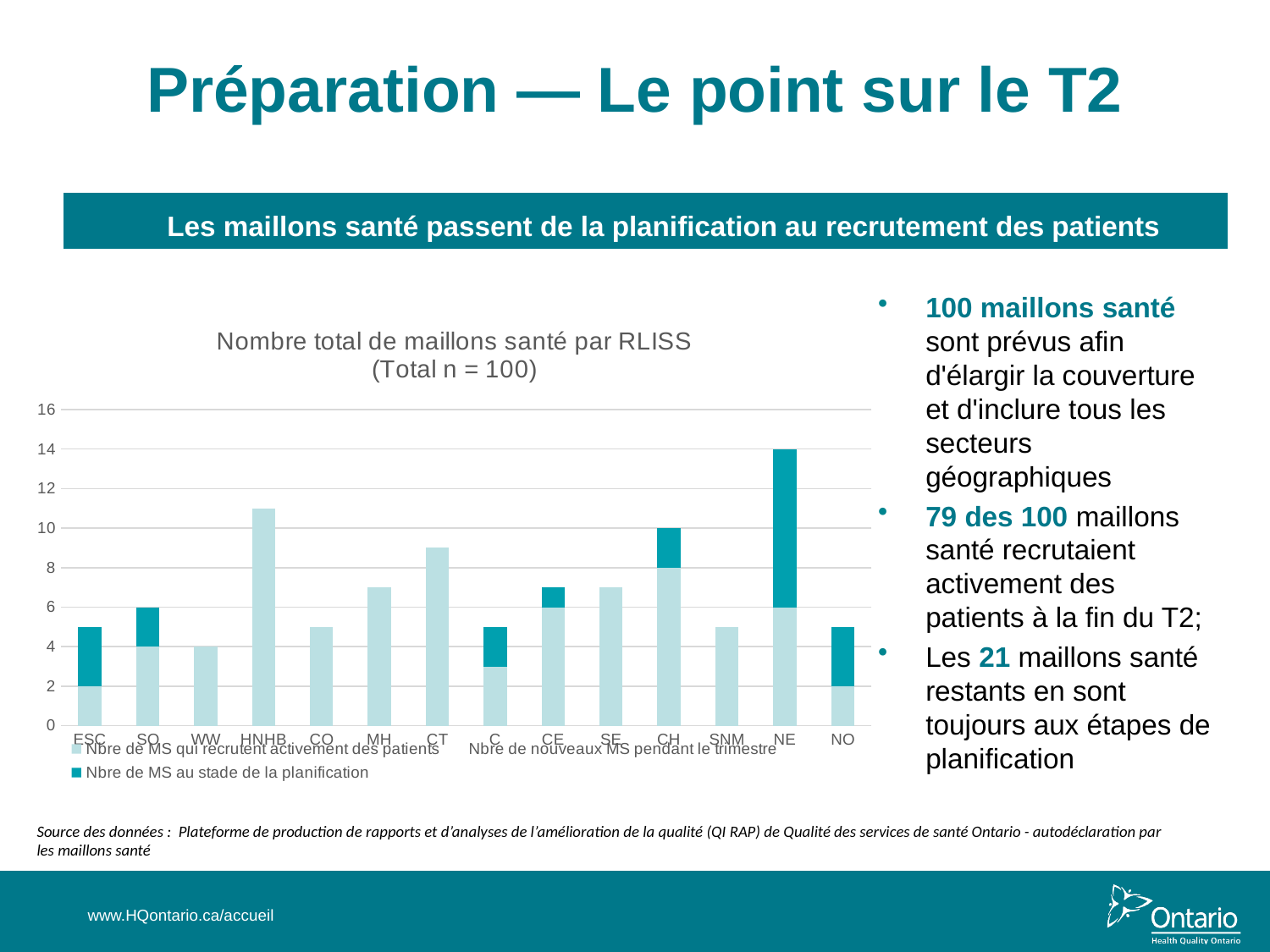
What kind of chart is shown on the slide? Stacked bar chart Which RLISS has the lowest total number of maillons santé? WW What is the total height of the bar for NE? 14 What is the value of 'Nbre de MS qui recrutent activement des patients' for ESC? 2 What is the title of the chart? Nombre total de maillons santé par RLISS (Total n = 100) How many series does the chart legend list? 3 Which has a taller total bar, HNHB or CT? HNHB How many RLISS categories are shown on the x axis of the chart? 14 What is the total height of the bar for WW? 4 Is the total value for HNHB greater or less than 10? greater What is the total height of the bar for CH? 10 Which RLISS has the highest total number of maillons santé? NE